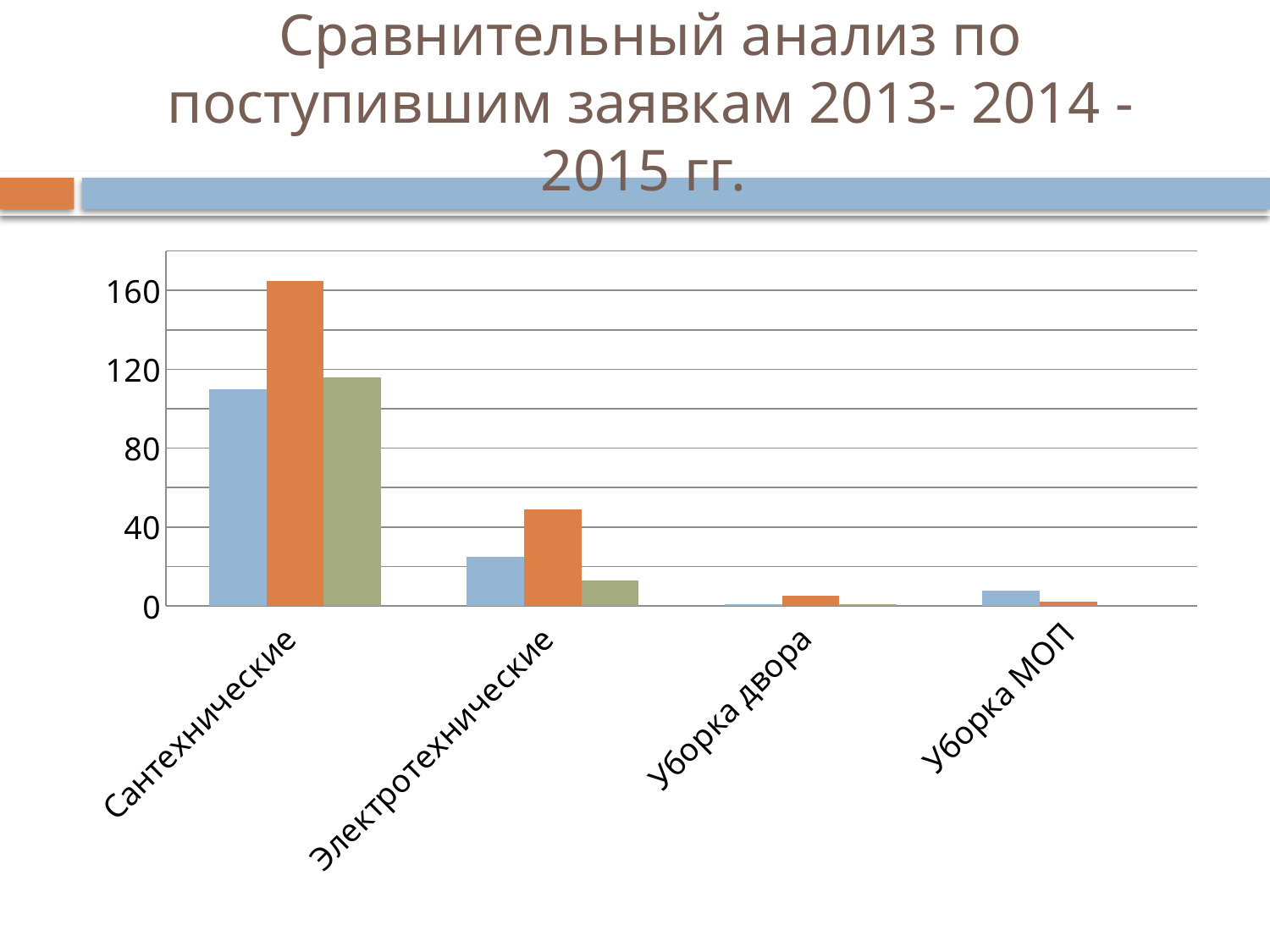
Is the value of the blue bar for Электротехнические greater or less than 40? less How many bars are plotted for the category Сантехнические? 3 Is the value of the blue bar for Сантехнические greater or less than 80? greater Is the value of the blue bar for Сантехнические greater or less than 120? less How many categories are shown on the x axis of the chart? 4 Which category has the lowest bars overall in the chart? уборка двора What kind of chart is shown on the slide? bar chart Which category has the tallest bar in the chart? Сантехнические For Электротехнические, which is larger: the blue bar or the green bar? the blue bar For Сантехнические, which is larger: the orange bar or the blue bar? the orange bar